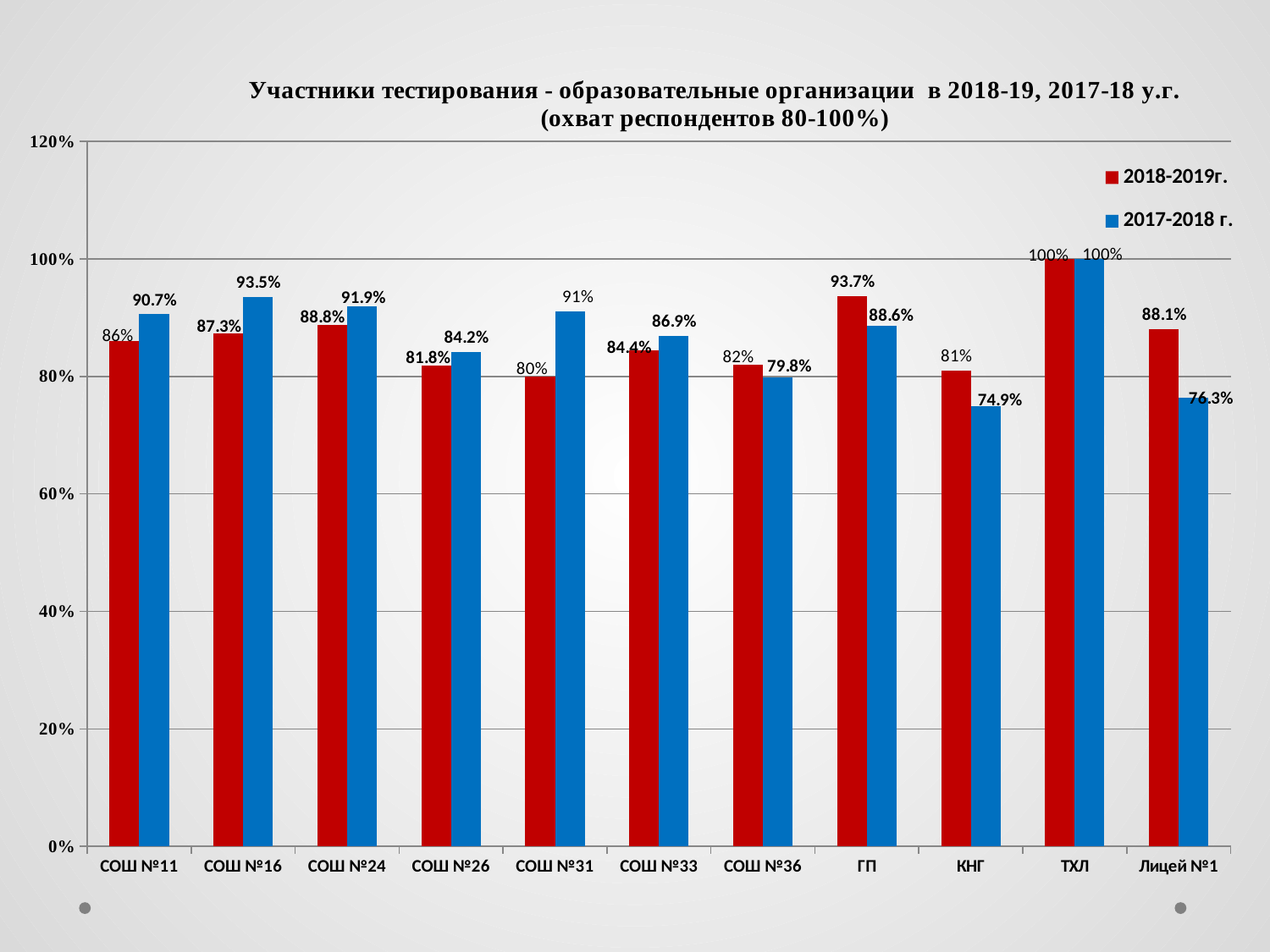
What is the difference between the 2018-2019г. and 2017-2018 г. values for Лицей №1? 11.8% How many series does the legend list? 2 What is the value for КНГ in the 2017-2018 г. series? 74.9% What is the value for Лицей №1 in the 2018-2019г. series? 88.1% How many categories are shown on the x axis? 11 What is the difference between the 2017-2018 г. and 2018-2019г. values for СОШ №31? 11% For ГП, which series has the larger value, 2018-2019г. or 2017-2018 г.? 2018-2019г. Which category has the highest value in the 2018-2019г. series? ТХЛ What is the value for СОШ №31 in the 2017-2018 г. series? 91% Which category has the lowest value in the 2018-2019г. series? СОШ №31 Which category has the lowest value in the 2017-2018 г. series? КНГ What is the value for СОШ №16 in the 2018-2019г. series? 87.3%